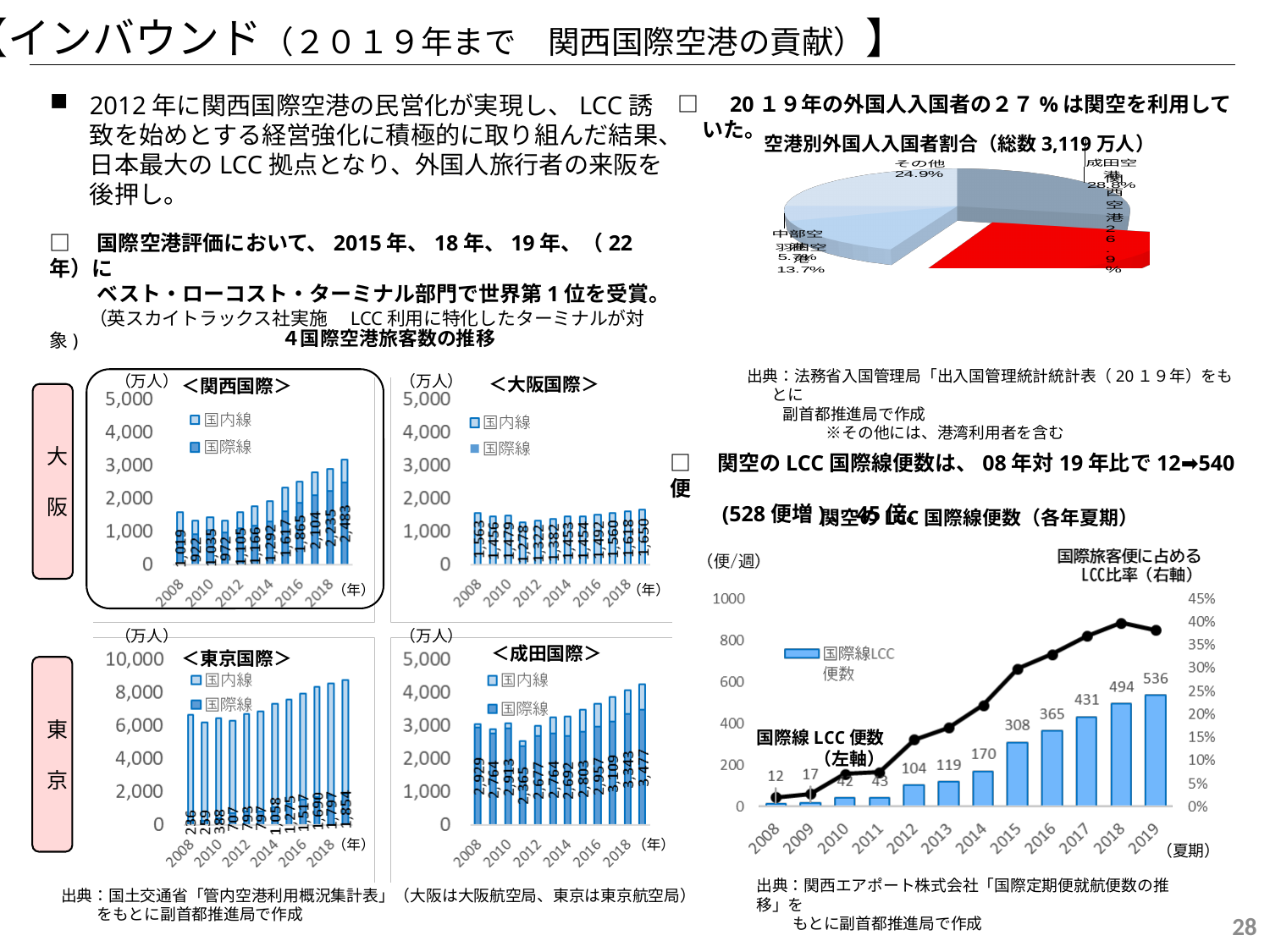
In the 関空のLCC国際線便数（各年夏期） chart, by how much did 国際線LCC便数 increase from 2018 to 2019? 42 In the 関空のLCC国際線便数（各年夏期） chart, what is the value of 国際線LCC便数 for 2019? 536 In the 関空のLCC国際線便数（各年夏期） chart, do the 国際線LCC便数 bars generally rise or fall from 2008 to 2019? rise In the 関空のLCC国際線便数（各年夏期） chart, is the LCC比率 (right axis) for 2019 greater or less than 35%? greater In the 空港別外国人入国者割合 pie chart, what share is labelled for その他? 24.9% In the ＜関西国際＞ chart, how many series does the legend list? 2 In the ＜関西国際＞ chart, what is the labelled value for 2019? 2,483 In the ＜成田国際＞ chart, what is the labelled value for 2019? 3,477 In the ＜東京国際＞ chart, what is the labelled value for 2008? 236 In the 関空のLCC国際線便数（各年夏期） chart, what is the value of 国際線LCC便数 for 2008? 12 In the 関空のLCC国際線便数（各年夏期） chart, how many years are plotted on the x axis? 12 In the ＜関西国際＞ chart, which year has the lowest labelled value? 2009